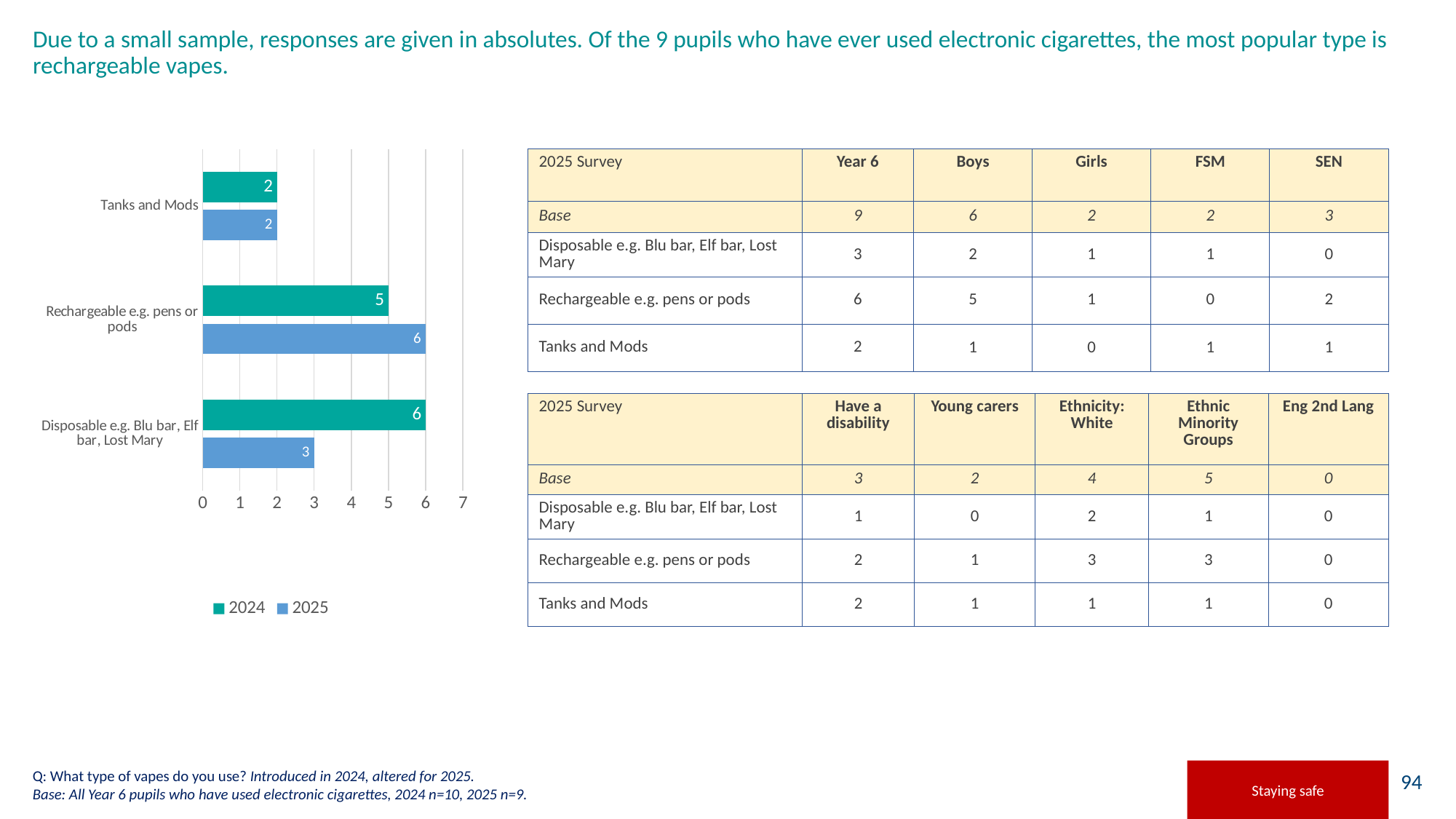
Which is larger for Rechargeable e.g. pens or pods, the 2024 value or the 2025 value? 2025 What is the 2025 value for Rechargeable e.g. pens or pods? 6 What is the 2024 value for Rechargeable e.g. pens or pods? 5 What kind of chart is shown on the slide? Bar chart What is the difference between the 2024 and 2025 values for Disposable e.g. Blu bar, Elf bar, Lost Mary? 3 What is the 2024 value for Disposable e.g. Blu bar, Elf bar, Lost Mary? 6 How many categories are shown on the chart? 3 How many series does the legend list? 2 What is the 2025 value for Tanks and Mods? 2 Which category has the highest 2025 value? Rechargeable e.g. pens or pods Which category has the lowest 2024 value? Tanks and Mods Which series is shown in blue in the legend? 2025